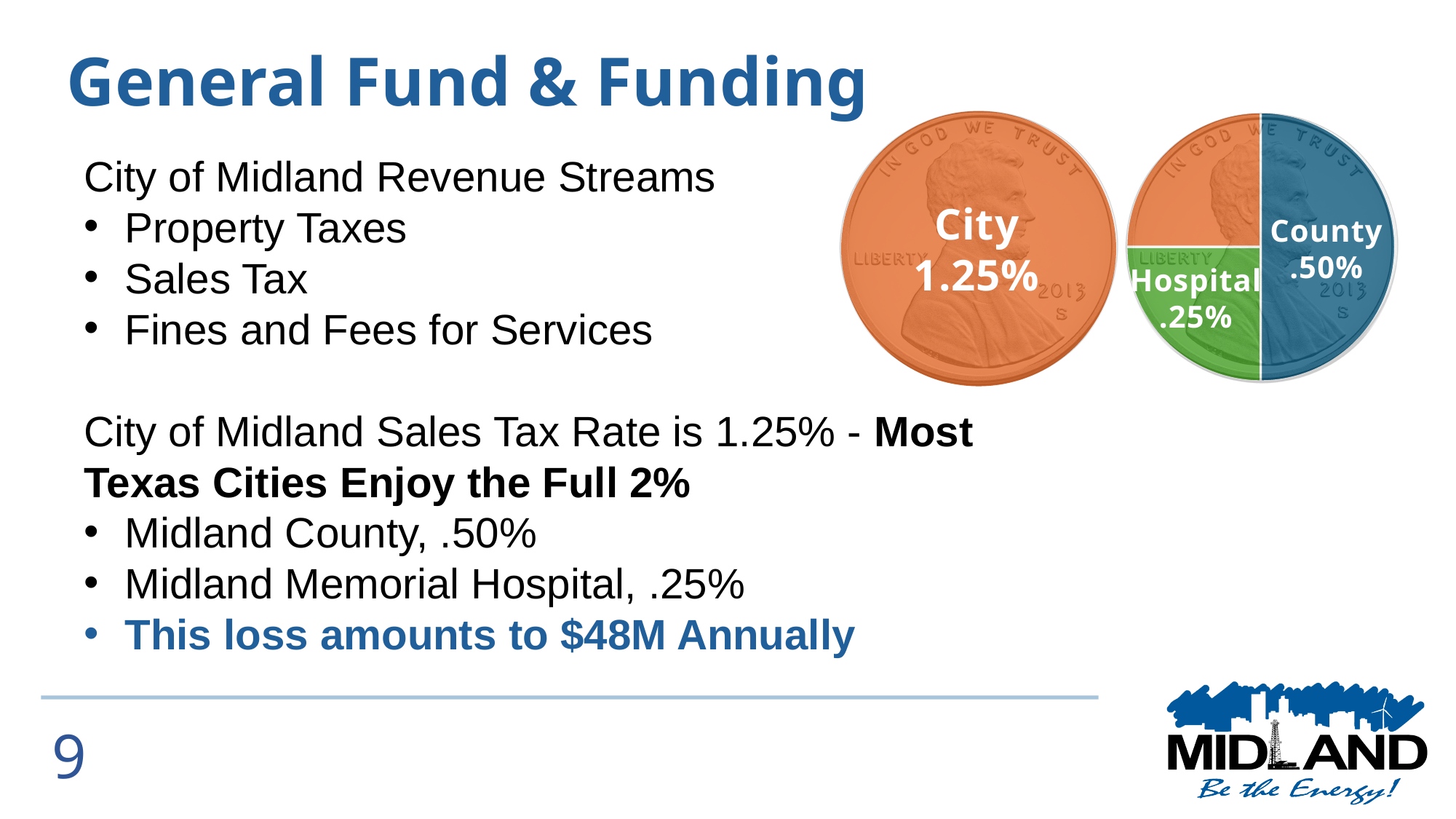
On the left penny graphic, what sales tax rate is shown for the City? 1.25% On the right penny graphic, what rate is shown for Hospital? .25% Across the two penny graphics, which labeled entity has the lowest rate? Hospital What is the difference between the City rate on the left penny and the County rate on the right penny? .75% On the right penny graphic, which is larger, the County rate or the Hospital rate? County On the right penny graphic, what is the difference between the County rate and the Hospital rate? .25% What colour is the Hospital segment on the right penny graphic? Green What kind of chart does the right penny graphic resemble, with its segments dividing the coin? Pie chart What is the combined total of the County and Hospital rates shown on the right penny graphic? .75% Across the two penny graphics, which labeled entity has the highest rate? City On the right penny graphic, what rate is shown for County? .50% What colour is the County segment on the right penny graphic? Blue